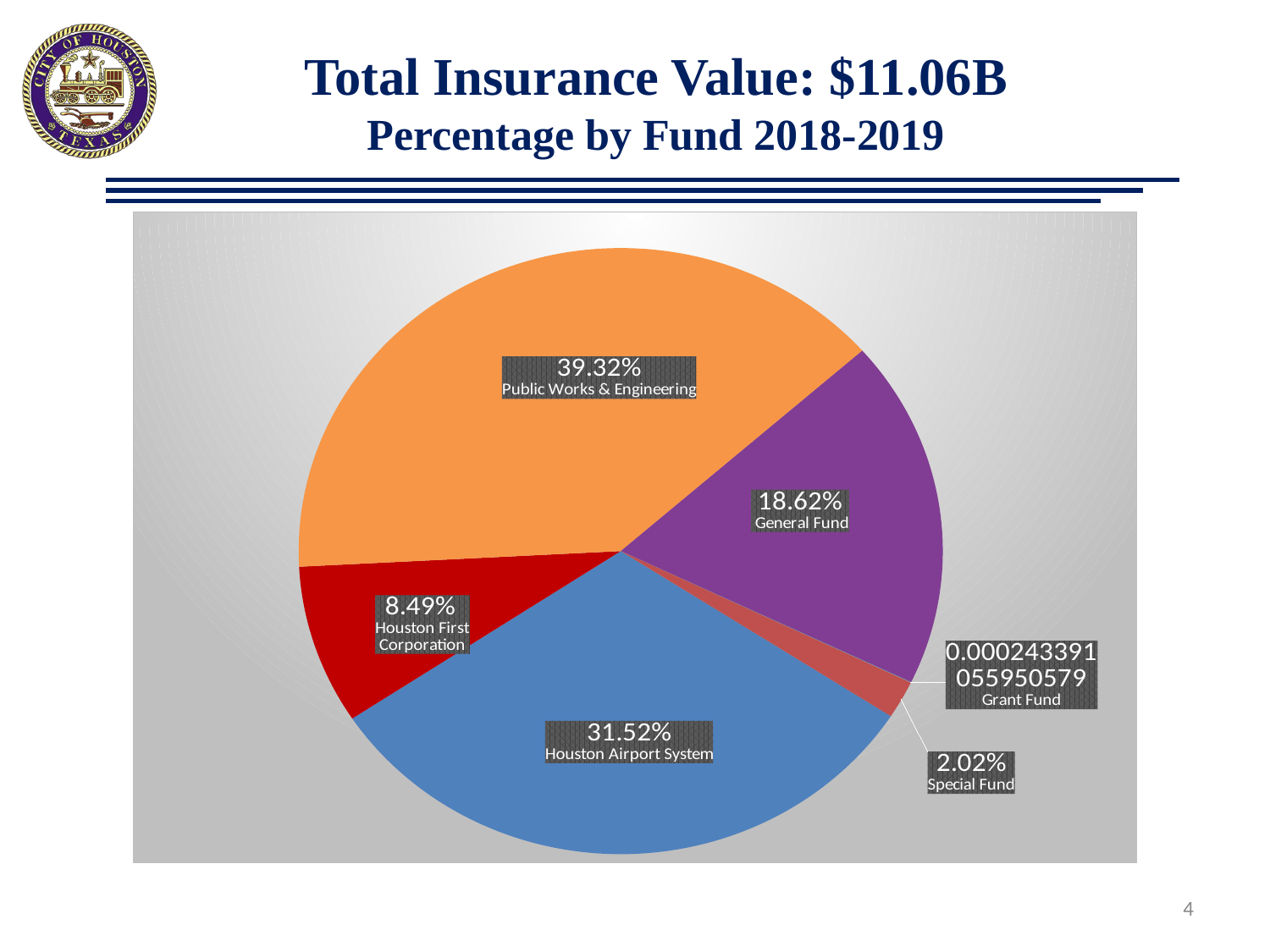
What percentage is shown for the Houston Airport System slice? 31.52% What percentage is shown for the General Fund? 18.62% Which fund has the largest share of the pie? Public Works & Engineering What total insurance value is stated in the slide title? $11.06B Which fund has the smallest share of the pie? Grant Fund What is the difference in percentage points between Public Works & Engineering and Houston Airport System? 7.80% What percentage is shown for Houston First Corporation? 8.49% Which is larger, the General Fund share or the Houston First Corporation share? General Fund What kind of chart is shown on the slide? Pie chart How many slices does the pie chart have? 6 What percentage is shown for the Special Fund? 2.02% What percentage of the total insurance value is attributed to Public Works & Engineering? 39.32%